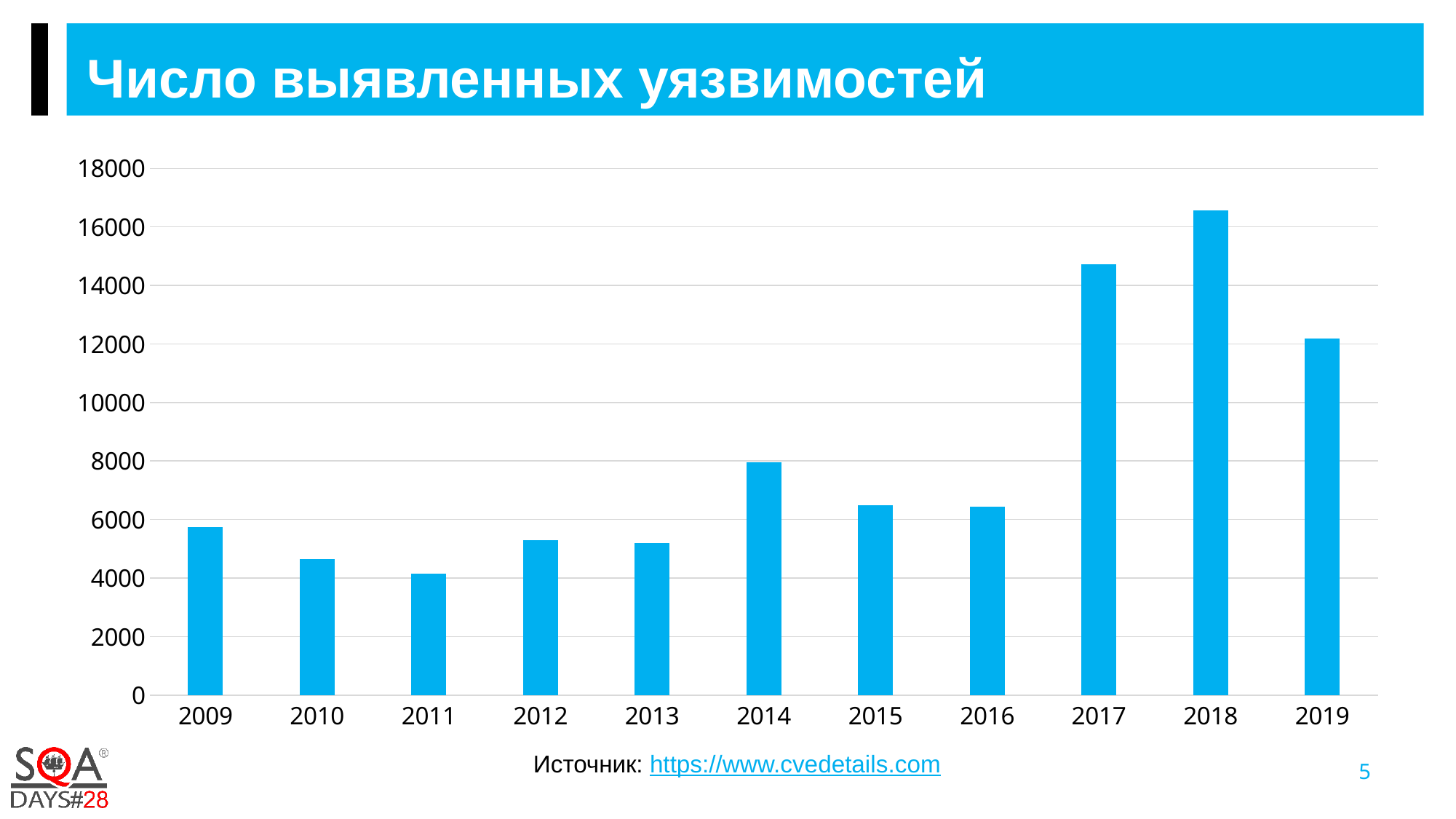
Which year has the lowest number of identified vulnerabilities? 2011 How many years are shown on the x axis of the chart? 11 What is the title of the chart? Число выявленных уязвимостей Which year has the highest number of identified vulnerabilities? 2018 Which year has the larger value, 2014 or 2015? 2014 Is the value for 2010 greater or less than 6000? less Do the values rise or fall from 2016 to 2018? rise What kind of chart is shown on the slide? bar chart Is the value for 2019 greater or less than 14000? less Is the value for 2018 greater or less than 16000? greater Which year has the larger value, 2017 or 2019? 2017